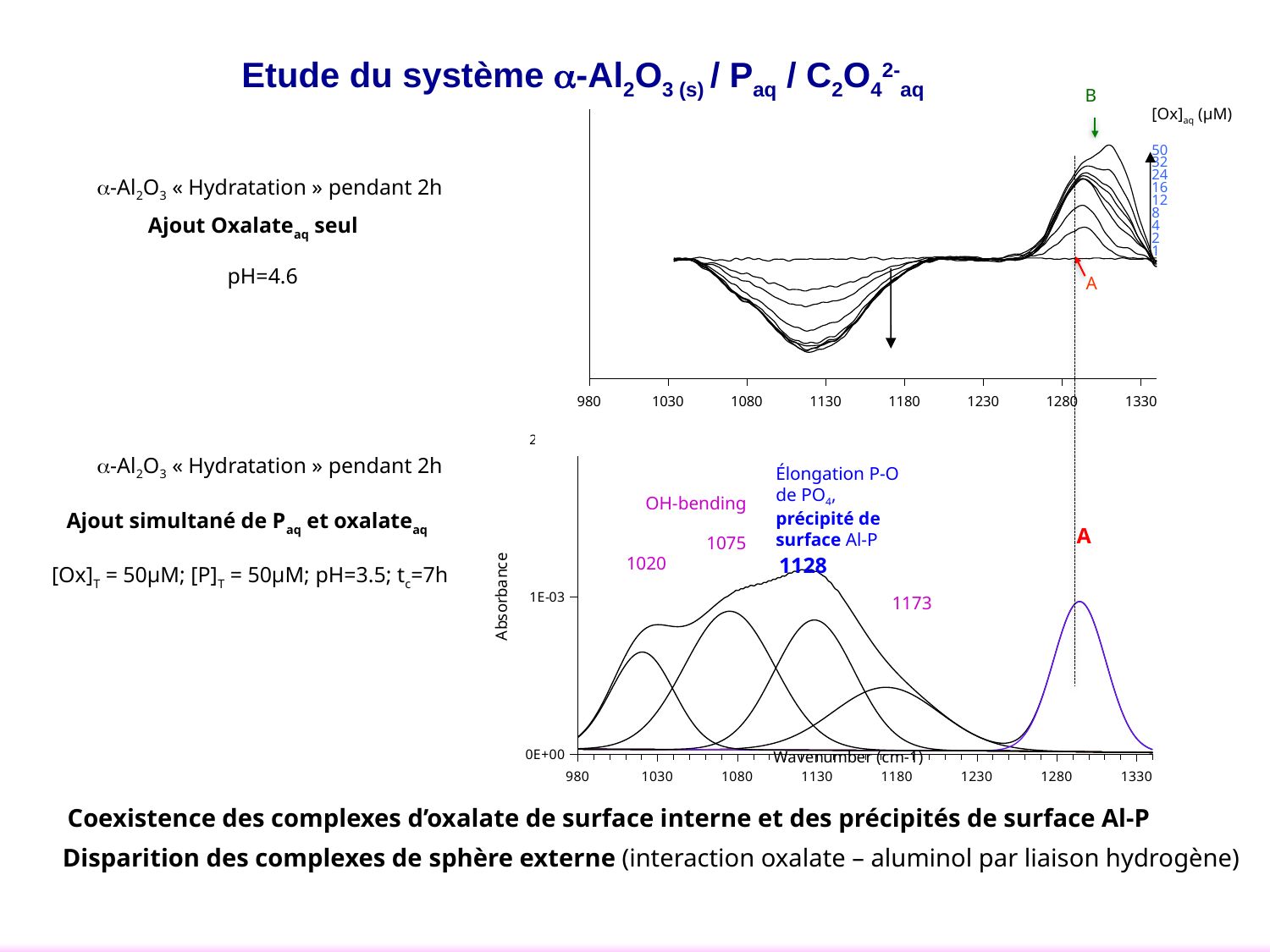
In the bottom chart, which two wavenumber labels are associated with OH-bending? 1020 and 1075 In the top chart, what unit is given for the oxalate concentration [Ox]aq? µM In the bottom chart, what wavenumber is labelled for the peak assigned to the P-O elongation of PO4 in the Al-P surface precipitate? 1128 What kind of chart is the top chart on the slide? line chart In the top chart, how many oxalate concentration values are listed on the right-hand side? 9 In the top chart, what are the first and last tick values on the x axis? 980 and 1330 In the bottom chart, how many wavenumber peak labels (1020, 1075, 1128, 1173) are printed? 4 In the bottom chart, what is the y-axis tick value printed above 0E+00? 1E-03 In the top chart, what is the lowest [Ox]aq concentration listed? 1 In the bottom chart, what is the y-axis label? Absorbance In the bottom chart, is the maximum of the overall envelope curve near 1128 greater or less than 1E-03? greater In the top chart, what is the highest [Ox]aq concentration listed? 50